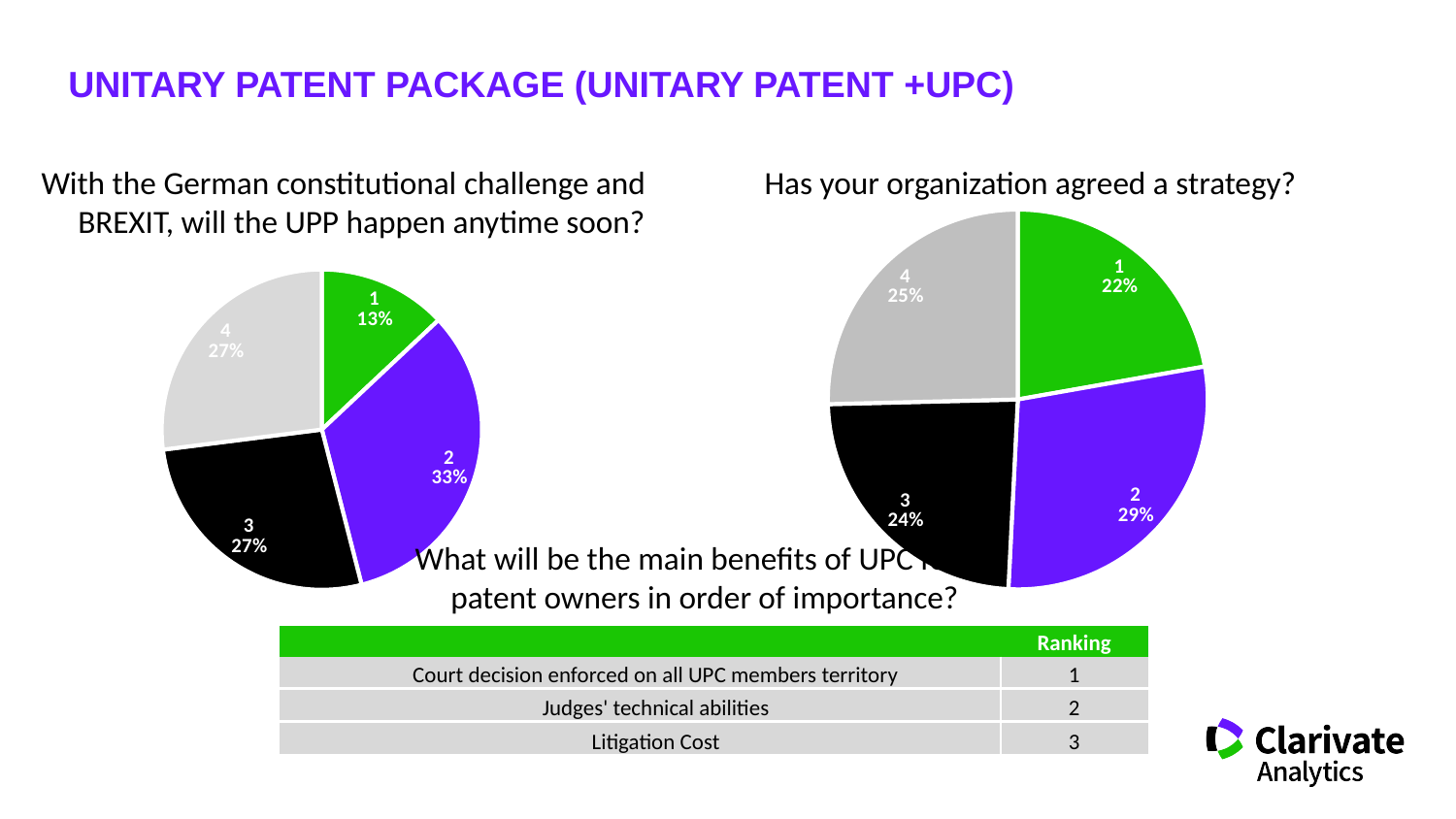
What type of chart is used for "With the German constitutional challenge and BREXIT, will the UPP happen anytime soon?"? Pie chart In the pie chart titled "With the German constitutional challenge and BREXIT, will the UPP happen anytime soon?", which slice has the largest share? 2 In the pie chart titled "Has your organization agreed a strategy?", which is larger, slice 2 or slice 1? 2 In the pie chart titled "Has your organization agreed a strategy?", which slice has the largest share? 2 In the pie chart titled "Has your organization agreed a strategy?", what percentage is shown for slice 3? 24% In the pie chart titled "With the German constitutional challenge and BREXIT, will the UPP happen anytime soon?", which slice has the smallest share? 1 In the pie chart titled "With the German constitutional challenge and BREXIT, will the UPP happen anytime soon?", what percentage is shown for slice 2? 33% How many slices does the pie chart titled "Has your organization agreed a strategy?" have? 4 In the pie chart titled "With the German constitutional challenge and BREXIT, will the UPP happen anytime soon?", what percentage is shown for slice 1? 13% In the pie chart titled "Has your organization agreed a strategy?", what percentage is shown for slice 4? 25% In the pie chart titled "Has your organization agreed a strategy?", which slice has the smallest share? 1 In the pie chart titled "With the German constitutional challenge and BREXIT, will the UPP happen anytime soon?", what is the difference in percentage points between slice 2 and slice 1? 20